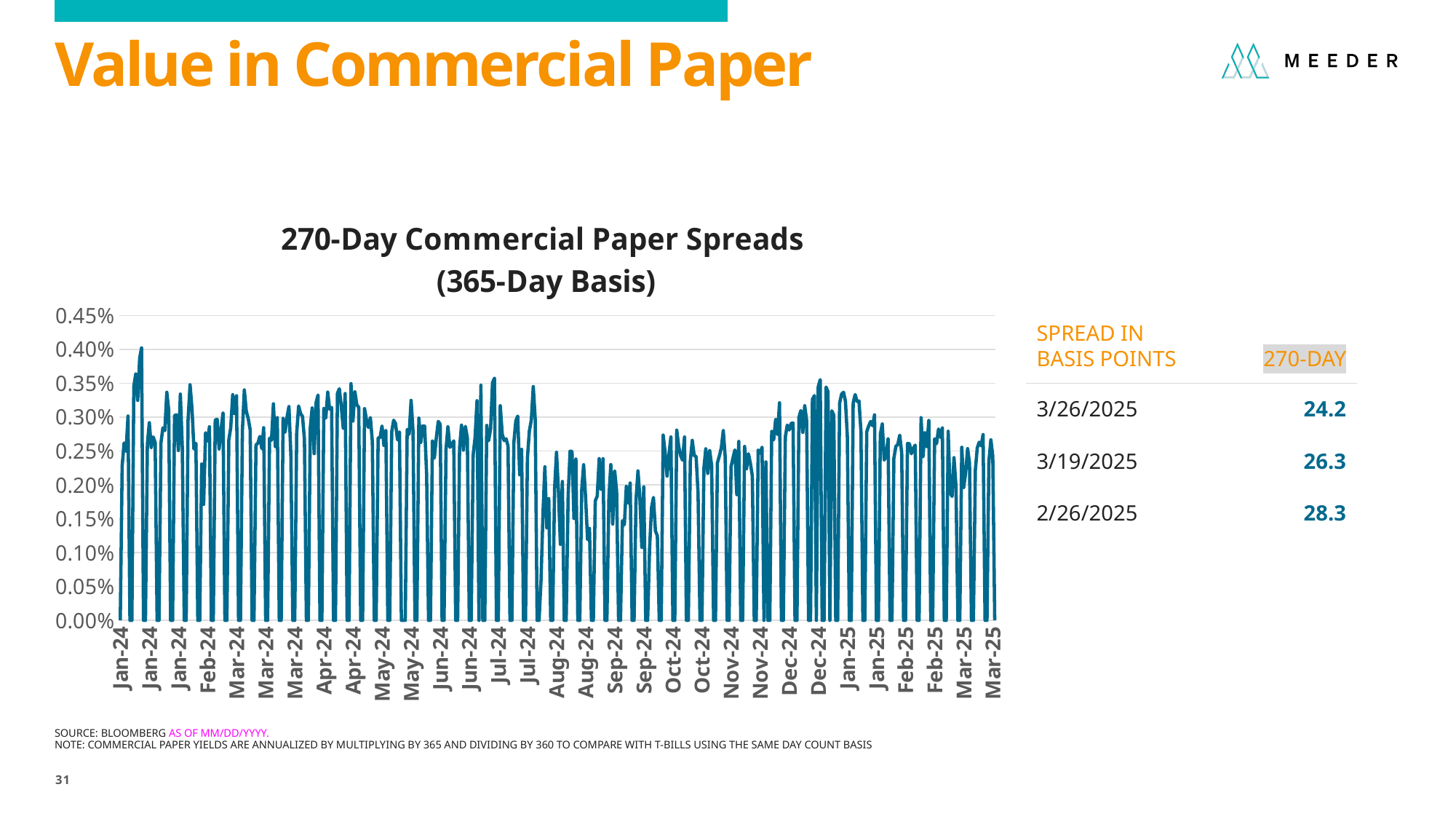
Are the peaks of the line in Sep-24 greater or less than 0.25%? less Do the peak spreads rise or fall from Jul-24 to Sep-24? fall What kind of chart is shown on the slide? Line chart What is the title of the chart? 270-Day Commercial Paper Spreads (365-Day Basis) What is the highest value shown on the chart's y axis? 0.45% In the table next to the chart, what is the 270-day spread in basis points on 2/26/2025? 28.3 How many data series are plotted on the chart? 1 In the table next to the chart, what is the difference between the 270-day spread on 2/26/2025 and on 3/26/2025? 4.1 Which month has the higher peak spread, Jan-24 or Sep-24? Jan-24 In the table next to the chart, what is the 270-day spread in basis points on 3/26/2025? 24.2 Is the highest peak of the line in Jan-24 greater or less than 0.35%? greater Is the highest peak of the line in Dec-24 greater or less than 0.30%? greater